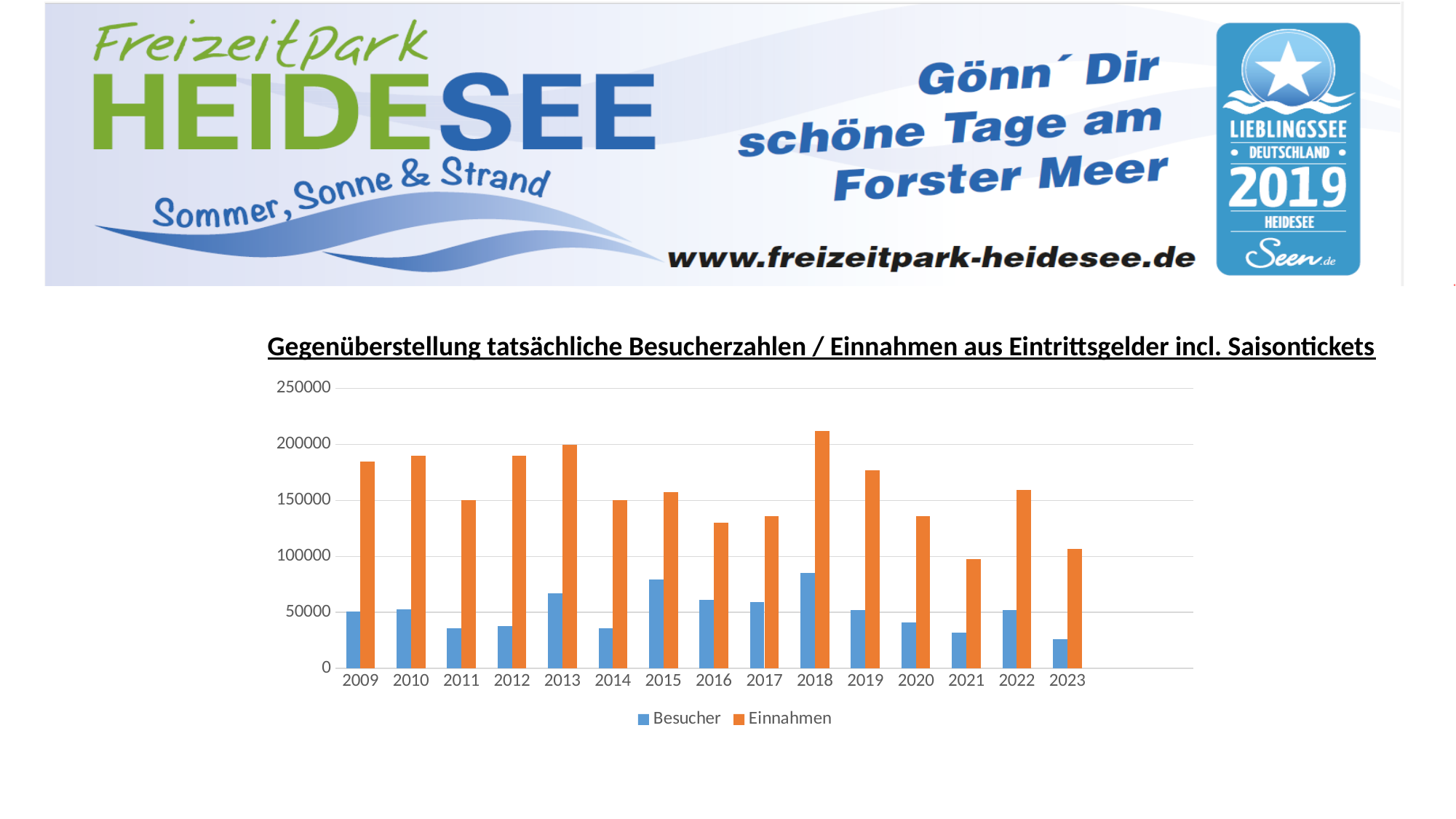
How many series does the chart legend list? 2 How many years are shown on the x axis of the chart? 15 What are the two series named in the chart legend? Besucher and Einnahmen Which year has the larger Besucher value, 2013 or 2014? 2013 In which year is the Besucher value lowest? 2023 Is the Einnahmen value for 2018 greater or less than 200000? greater Is the Besucher value for 2023 greater or less than 50000? less In which year is the Einnahmen value highest? 2018 What kind of chart is shown on the slide? bar chart Is the Besucher value for 2015 greater or less than 50000? greater In which year is the Einnahmen value lowest? 2021